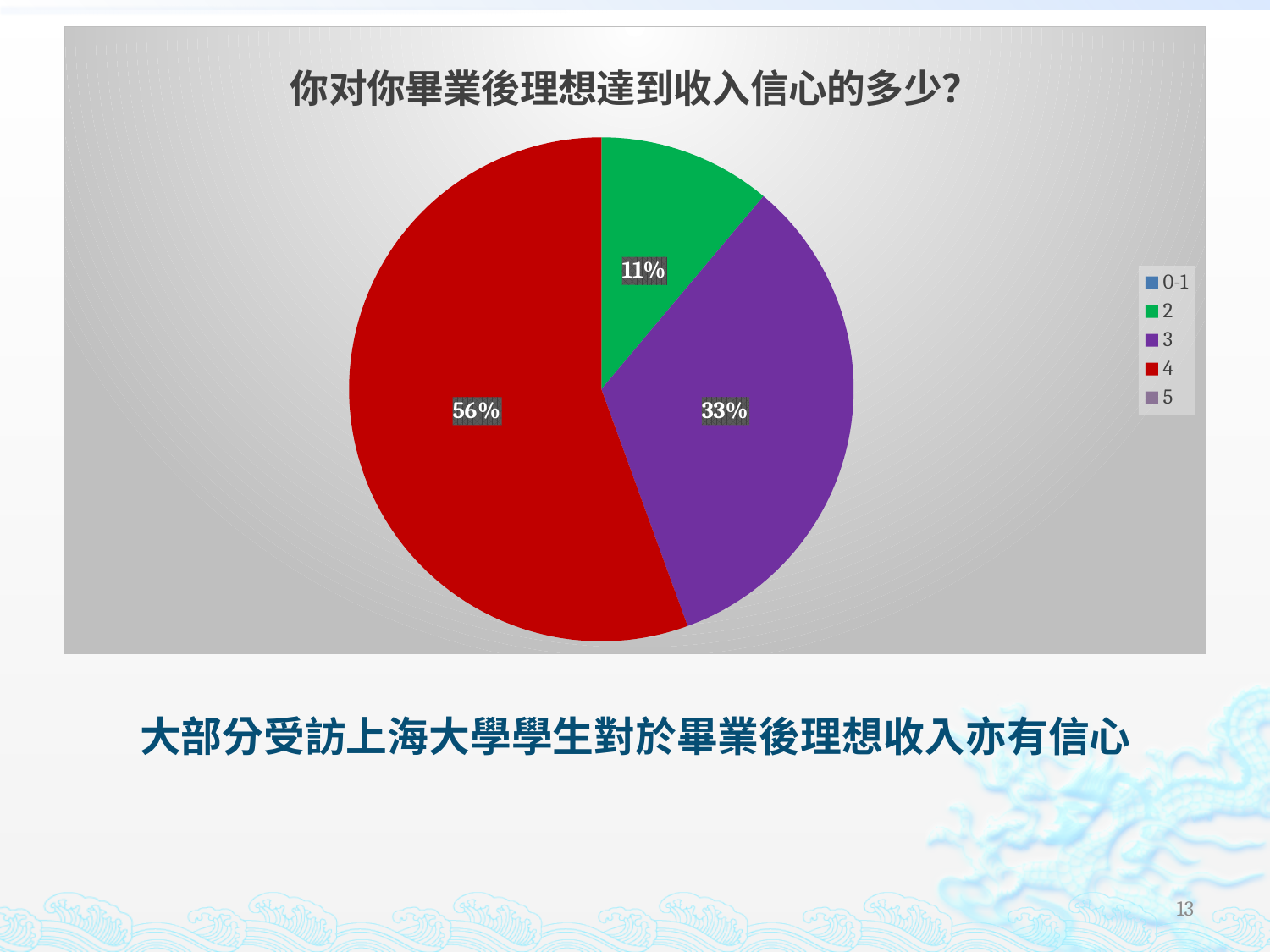
What kind of chart is shown on the slide? pie chart What share of the pie does category 2 take? 11% What colour is the slice for category 4? red Which category has the largest slice of the pie? 4 What share of the pie does category 4 take? 56% Among the slices with printed labels, which category has the smallest slice? 2 What is the difference in percentage points between the slices for category 3 and category 2? 22% What is the title of the chart? 你对你畢業後理想達到收入信心的多少? Which slice is larger, category 3 or category 2? 3 How many entries does the chart's legend list? 5 What share of the pie does category 3 take? 33% What is the difference in percentage points between the slices for category 4 and category 3? 23%